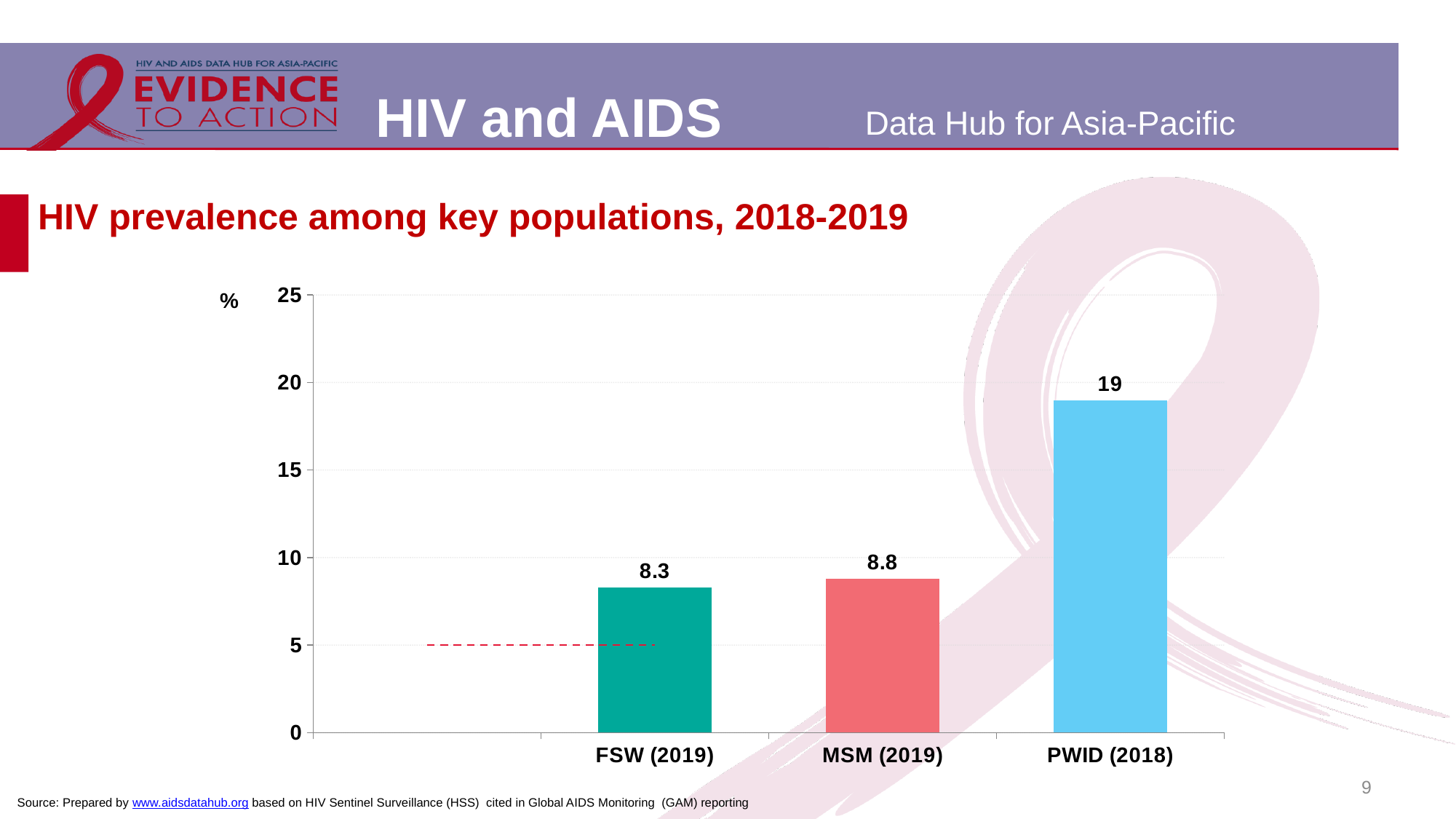
What is the HIV prevalence value shown for FSW (2019)? 8.3 What is the difference between the HIV prevalence for MSM (2019) and FSW (2019)? 0.5 What is the title of the chart on the slide? HIV prevalence among key populations, 2018-2019 What is the HIV prevalence value shown for MSM (2019)? 8.8 Which is larger, the HIV prevalence for PWID (2018) or for FSW (2019)? PWID (2018) Which key population has the highest HIV prevalence on the chart? PWID (2018) Is the value for PWID (2018) greater or less than 15? greater How many key population categories are shown on the chart? 3 What is the HIV prevalence value shown for PWID (2018)? 19 What kind of chart is shown on the slide? Bar chart Which key population has the lowest HIV prevalence on the chart? FSW (2019) What is the difference between the HIV prevalence for PWID (2018) and MSM (2019)? 10.2